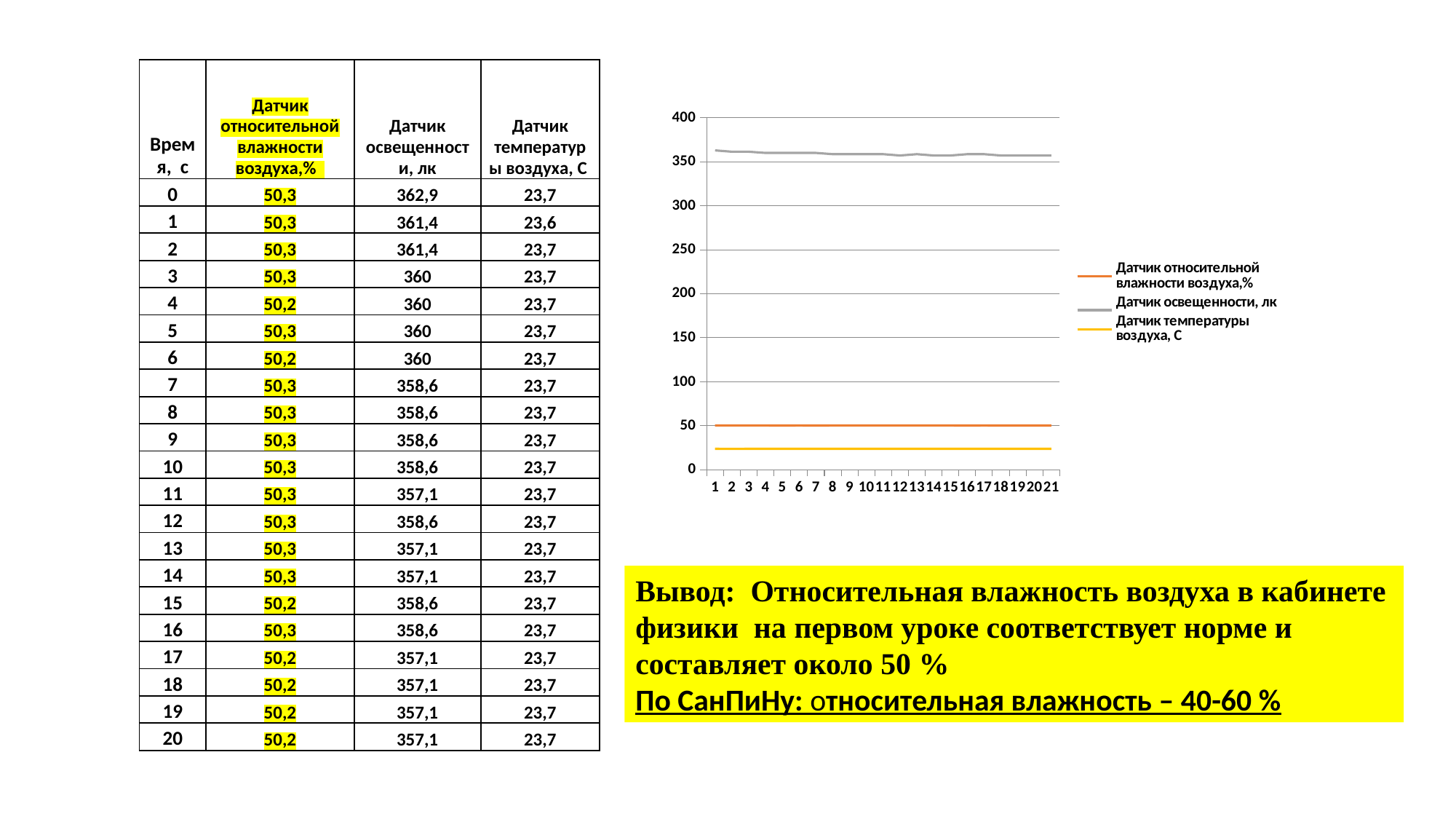
What kind of chart is shown on the slide? line chart Which series has the highest values on the chart? Датчик освещенности, лк How many points are plotted along the x axis of the chart? 21 What is the highest tick value shown on the chart's y axis? 400 Is the value of the series 'Датчик температуры воздуха, С' greater or less than 50? less Is the value of the series 'Датчик относительной влажности воздуха,%' greater or less than 100? less Which series is plotted higher: 'Датчик относительной влажности воздуха,%' or 'Датчик температуры воздуха, С'? Датчик относительной влажности воздуха,% How many series does the chart legend list? 3 Does the line for 'Датчик освещенности, лк' rise or fall along the x axis? falls slightly What colour is the line for 'Датчик освещенности, лк'? gray Is the value of the series 'Датчик освещенности, лк' greater or less than 350? greater Which series has the lowest values on the chart? Датчик температуры воздуха, С